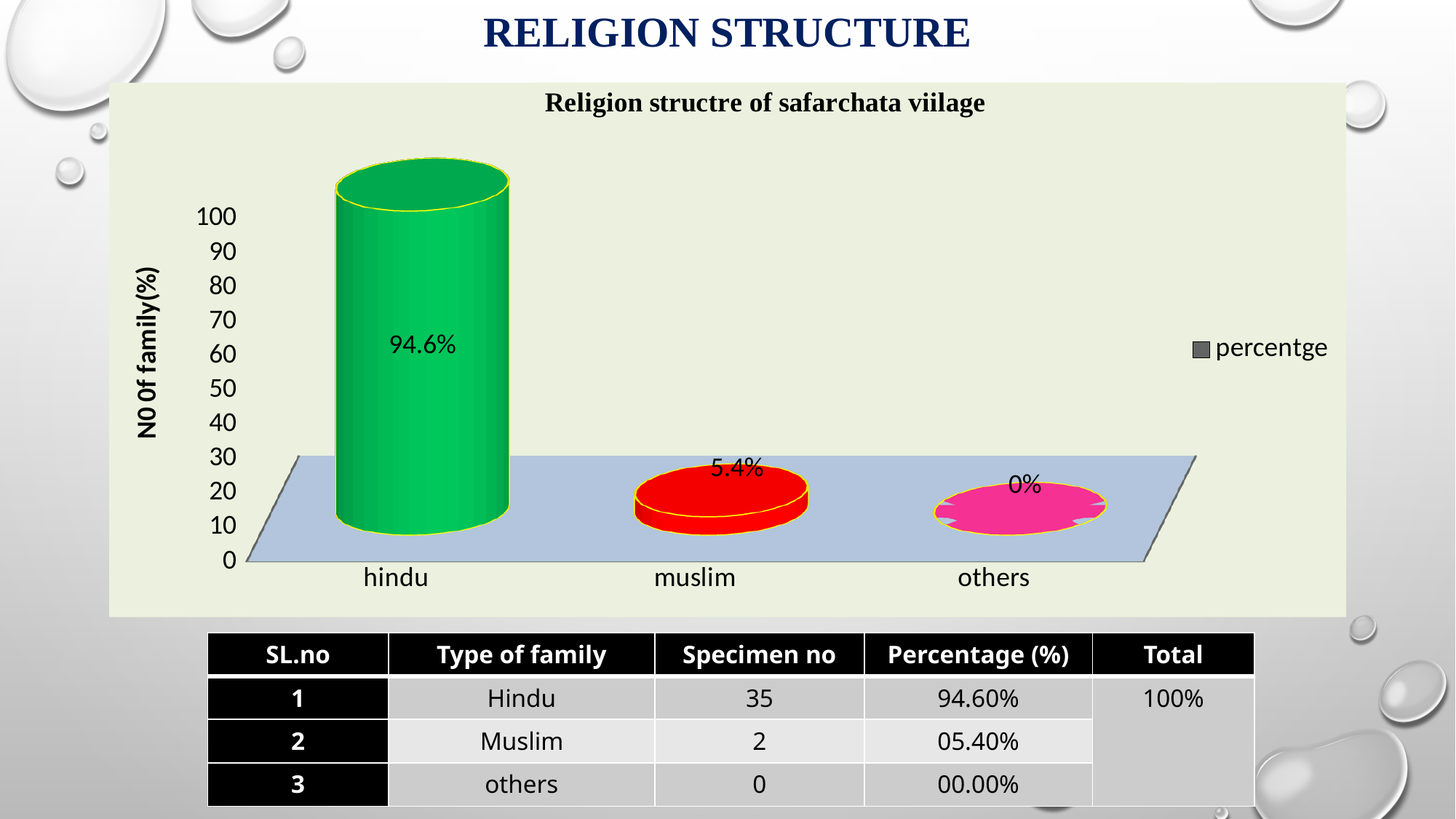
Is the value for hindu greater or less than 90? greater What is the title of the chart? Religion structre of safarchata viilage Which category has the highest value? hindu What is the value for hindu? 94.6% What is the value for others? 0% What kind of chart is shown? bar chart Which category has the lowest value? others What is the value for muslim? 5.4% Which is larger, the value for muslim or the value for others? muslim How many series does the legend list? 1 How many categories are shown on the x axis? 3 What is the difference between the values for hindu and muslim? 89.2%